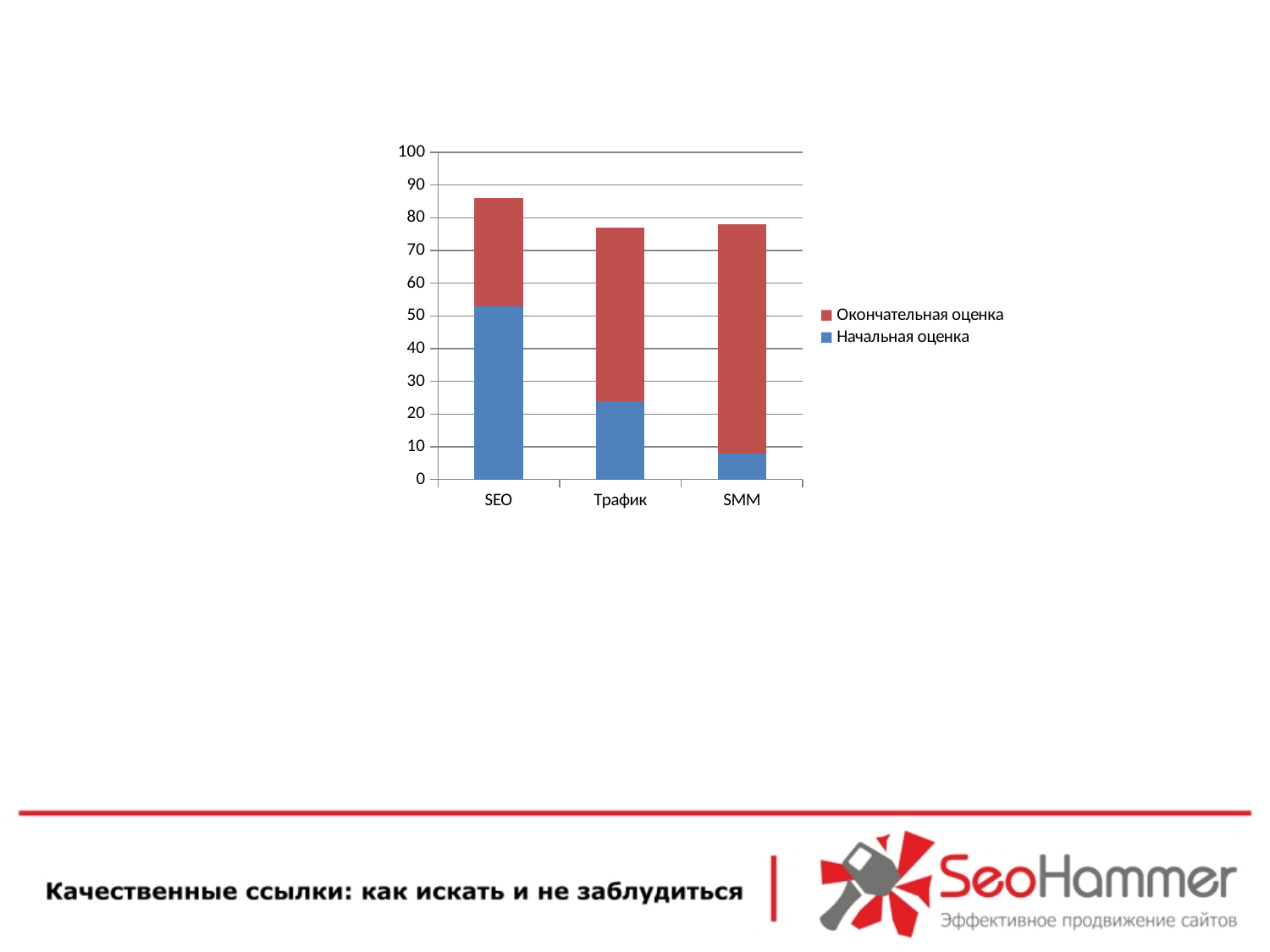
Which category has the lowest value for Начальная оценка? SMM Is the Начальная оценка value for SMM greater or less than 10? less Which is larger, the Начальная оценка value for SEO or for Трафик? SEO How many categories are shown on the x axis of the chart? 3 How many series does the chart legend list? 2 Which category has the tallest stacked bar overall? SEO What kind of chart is shown on the slide? stacked bar chart Is the total stacked bar for SEO greater or less than 80? greater Is the Начальная оценка value for Трафик greater or less than 30? less Which colour represents Окончательная оценка in the chart? red Which category has the highest value for Начальная оценка? SEO